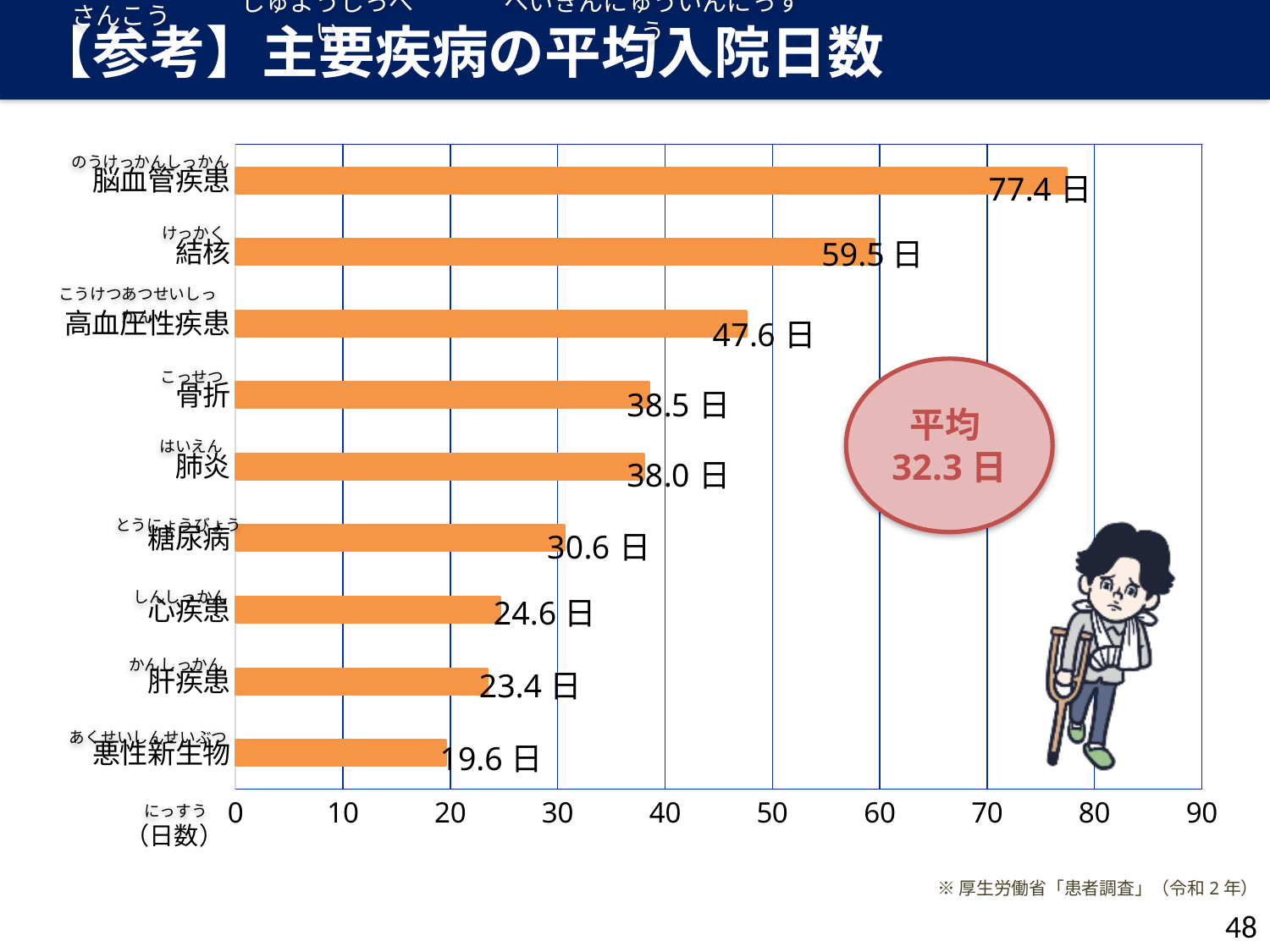
Which has a longer average hospitalization, 骨折 or 糖尿病? 骨折 What is the average number of hospitalization days for 脳血管疾患? 77.4 日 What is the average number of hospitalization days for 肝疾患? 23.4 日 What is the difference in average hospitalization days between 結核 and 高血圧性疾患? 11.9 日 How many diseases are shown in the chart? 9 Which disease has the shortest average hospitalization? 悪性新生物 Which disease has the longest average hospitalization? 脳血管疾患 Is the value for 肺炎 greater or less than 40? less What is the average number of hospitalization days for 糖尿病? 30.6 日 What is the difference in average hospitalization days between 心疾患 and 悪性新生物? 5.0 日 What overall average number of hospitalization days is shown in the circle on the chart? 32.3 日 What kind of chart is shown on the slide? bar chart